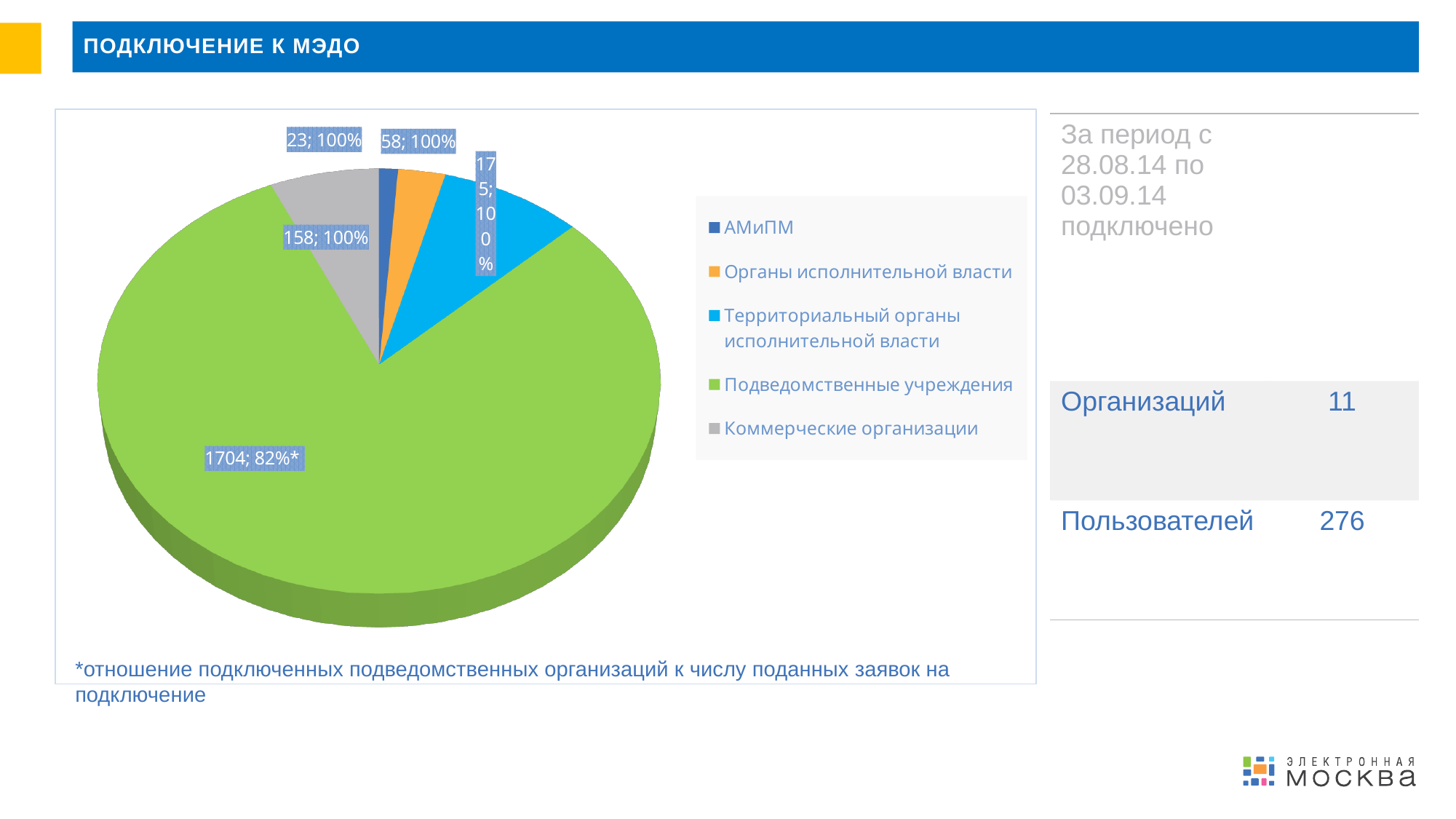
What value is labelled on the slice for Коммерческие организации? 158 Which category has the largest slice in the pie chart? Подведомственные учреждения What value is labelled on the slice for Органы исполнительной власти? 58 What value is labelled on the slice for Территориальный органы исполнительной власти? 175 What is the difference between the values for Территориальный органы исполнительной власти and Коммерческие организации? 17 What value is labelled on the slice for Подведомственные учреждения? 1704 Which category has the smallest slice in the pie chart? АМиПМ Which is larger, the value for Органы исполнительной власти or the value for АМиПМ? Органы исполнительной власти What colour is the slice for Коммерческие организации? grey What value is labelled on the slice for АМиПМ? 23 How many categories does the pie chart show? 5 What kind of chart is shown on the slide? pie chart